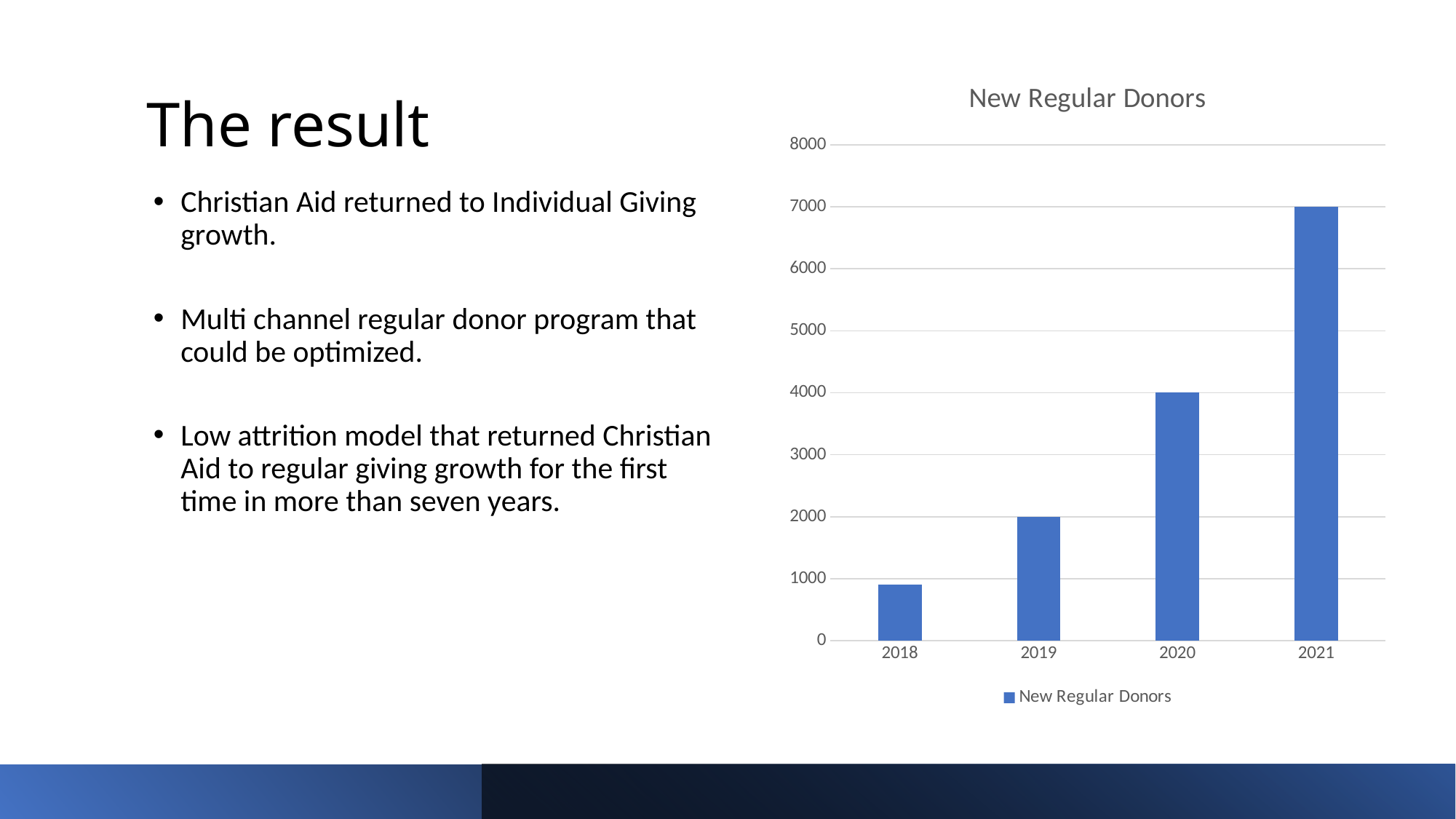
What is the title of the chart? New Regular Donors What is the difference between the values for 2021 and 2020? 3000 How many series does the legend list? 1 What is the value for 2019 in the New Regular Donors chart? 2000 What is the value for 2021 in the New Regular Donors chart? 7000 What is the value for 2020 in the New Regular Donors chart? 4000 How many years are shown on the x axis of the chart? 4 Which year has the lowest number of new regular donors? 2018 Do the values rise or fall from 2018 to 2021? rise Which year has the highest number of new regular donors? 2021 What kind of chart is shown on the slide? bar chart Is the value for 2018 greater or less than 1000? less